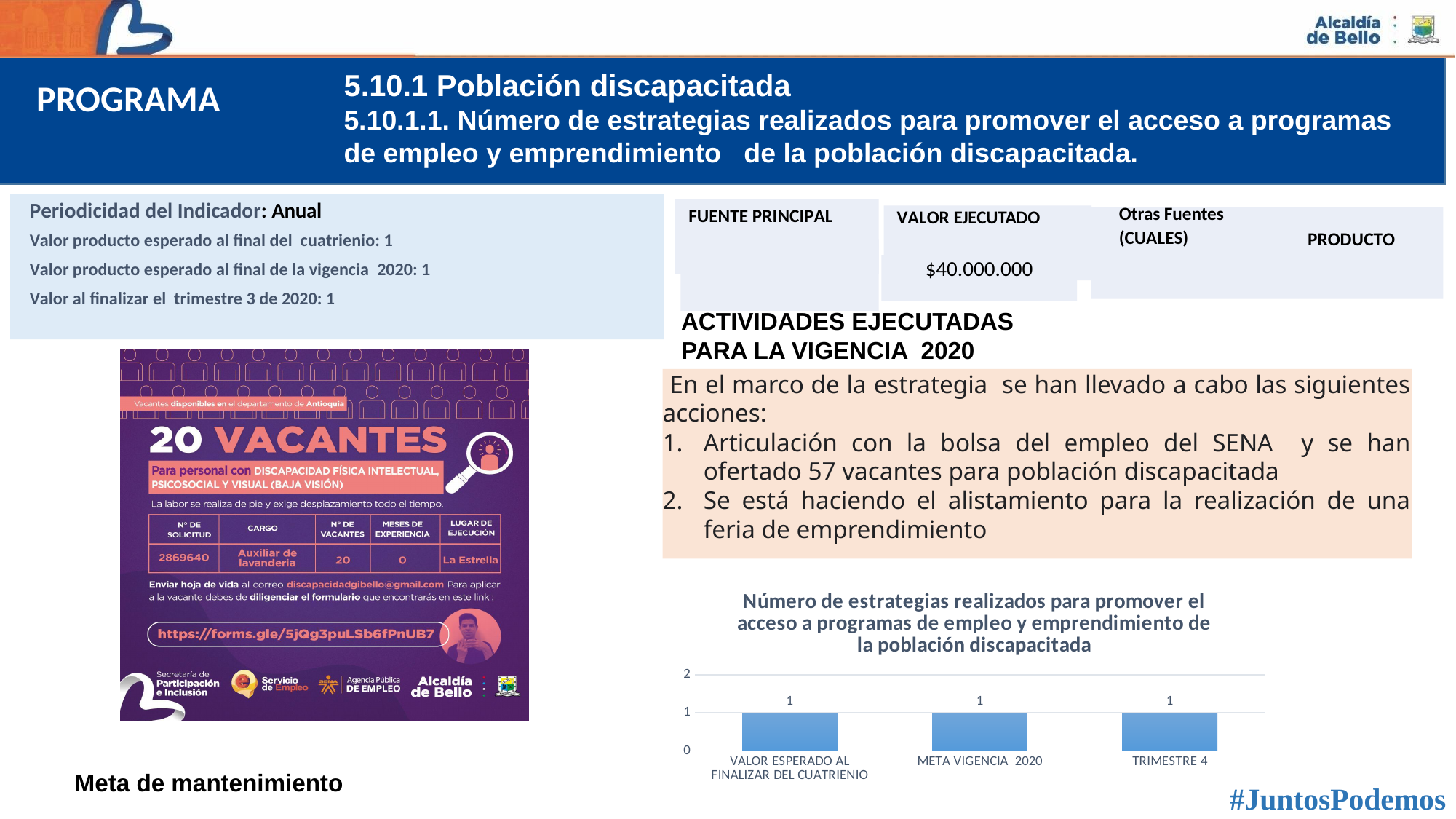
What is the difference between the value for META VIGENCIA 2020 and the value for TRIMESTRE 4? 0 What is the value for VALOR ESPERADO AL FINALIZAR DEL CUATRIENIO in the bar chart? 1 What is the value for TRIMESTRE 4 in the bar chart? 1 Do the values in the bar chart rise, fall, or stay flat from left to right? Stay flat What is the highest value shown on the y axis of the bar chart? 2 How many categories are shown on the x axis of the bar chart? 3 What is the value for META VIGENCIA 2020 in the bar chart? 1 Is the value for TRIMESTRE 4 greater or less than 2? less What is the title of the bar chart? Número de estrategias realizados para promover el acceso a programas de empleo y emprendimiento de la población discapacitada What kind of chart is shown at the bottom right of the slide? Bar chart